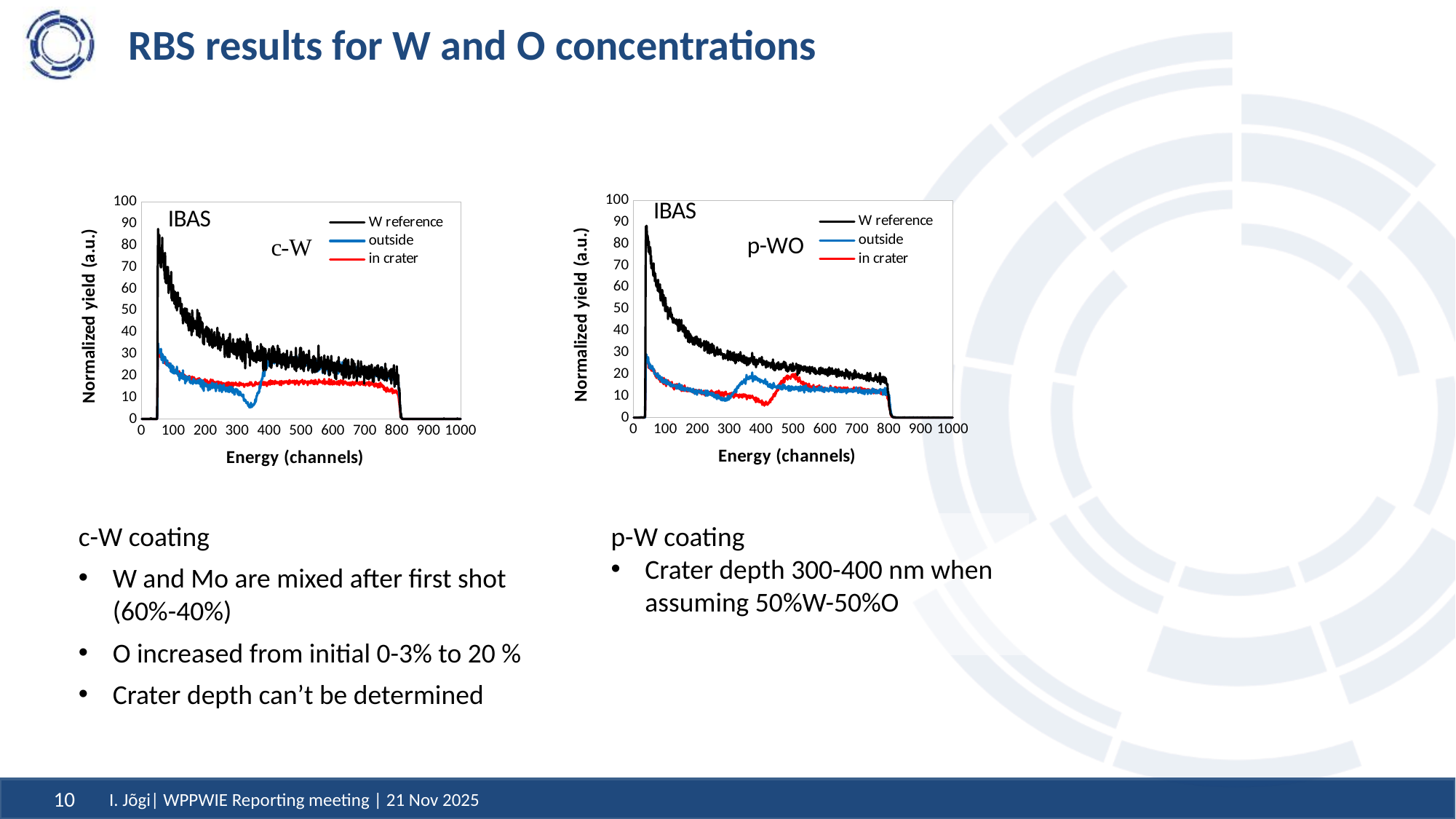
On the left chart (c-W), which series reaches the highest value overall? W reference On the left chart (c-W), which series has the higher value at 100 channels, W reference or outside? W reference What kind of chart is the left chart labelled c-W? line chart What are the three legend entries on the left chart (c-W)? W reference, outside, in crater On the right chart (p-WO), is the W reference value at 900 channels greater or less than 10? less On the right chart (p-WO), which series has the higher value at 400 channels, outside or in crater? outside On the right chart (p-WO), is the W reference value at 100 channels greater or less than 40? greater What is the x-axis title of the right chart (p-WO)? Energy (channels) On the left chart (c-W), is the W reference value at 100 channels greater or less than 50? greater How many series does the legend of the right chart (p-WO) list? 3 On the right chart (p-WO), does the W reference curve rise or fall between 100 and 800 channels? fall